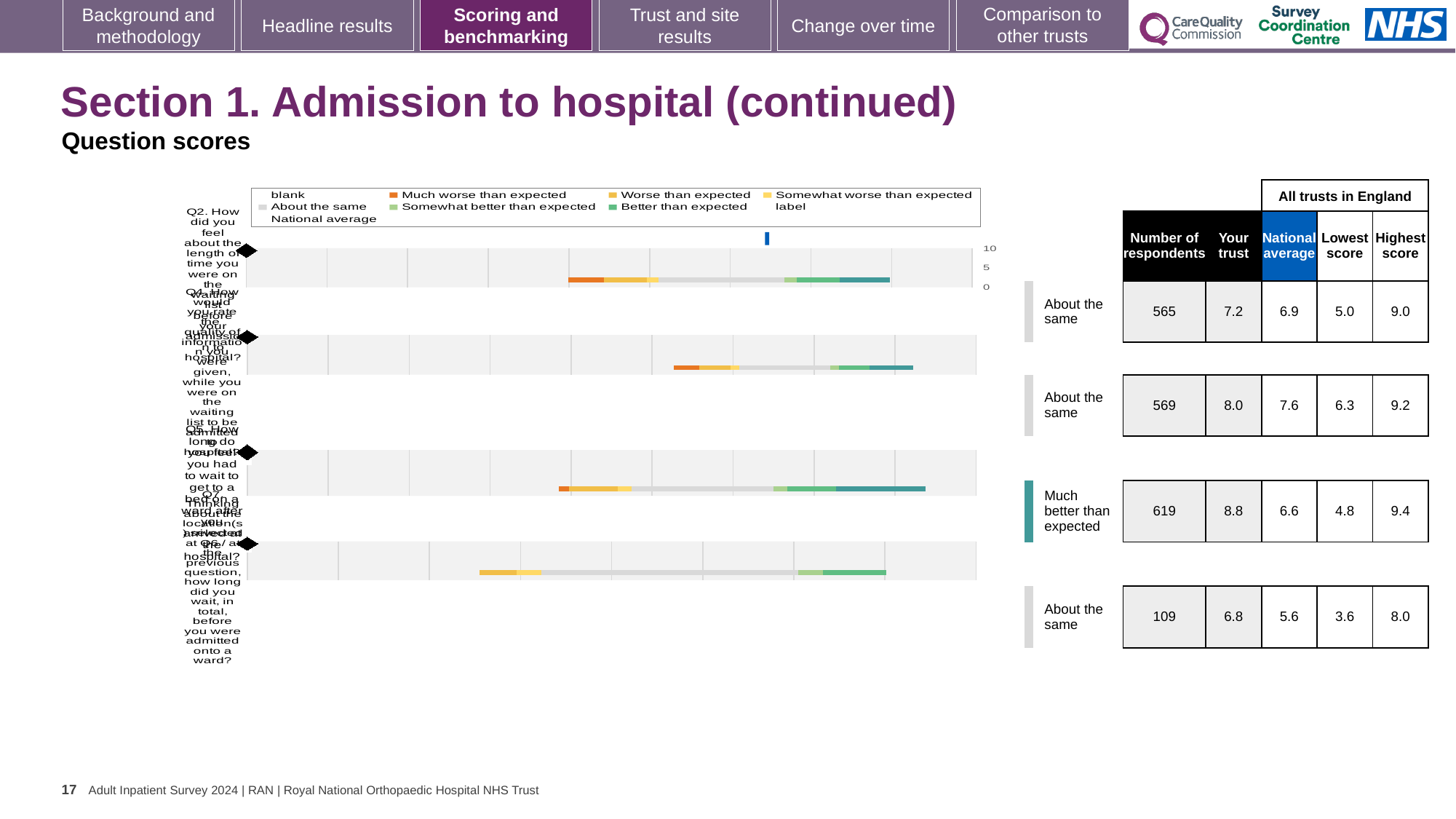
In the table, what is the 'Your trust' score for the top row (565 respondents)? 7.2 Which row has the highest 'Your trust' score in the table? the third row (619 respondents), 8.8 For the top row (565 respondents), which is larger: the 'Your trust' score or the national average? Your trust How many rows are labelled 'About the same'? 3 What kind of chart is shown on the slide? bar chart What is the highest score across all trusts in England for the second row (569 respondents)? 9.2 In the table, what is the national average for the third row (619 respondents)? 6.6 What is the lowest score across all trusts in England for the bottom row (109 respondents)? 3.6 How many questions (rows) are plotted in the chart? 4 For the third row (619 respondents), what is the difference between the 'Your trust' score and the national average? 2.2 What benchmark label is given to the third row (619 respondents)? Much better than expected Which row has the lowest 'Your trust' score in the table? the bottom row (109 respondents), 6.8